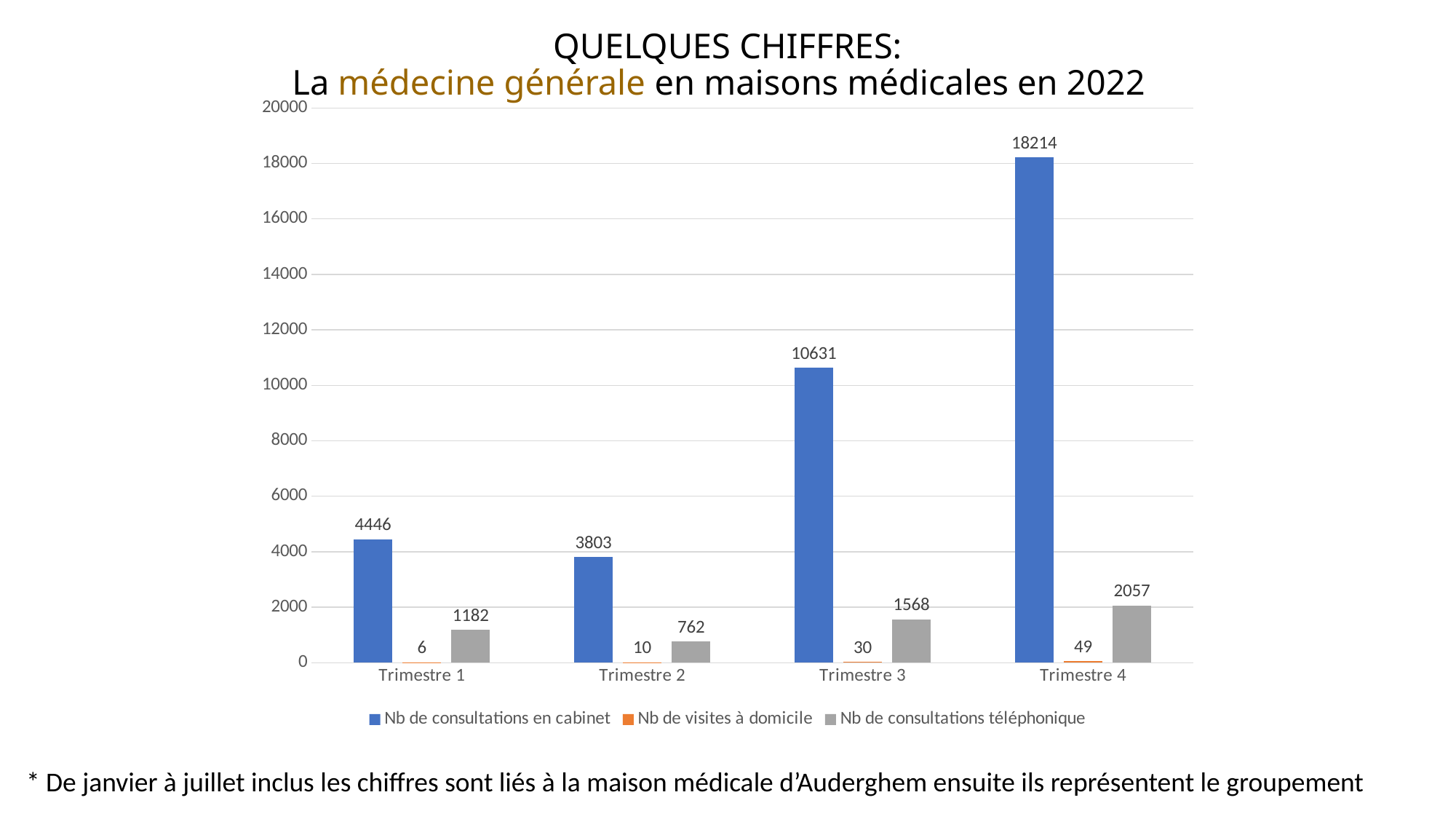
Is the value for 'Nb de consultations en cabinet' in Trimestre 3 greater or less than 10000? greater What kind of chart is shown on the slide? Bar chart What is the value of 'Nb de consultations en cabinet' for Trimestre 4? 18214 What is the value of 'Nb de consultations téléphonique' for Trimestre 1? 1182 Which trimestre has the lowest value for 'Nb de consultations téléphonique'? Trimestre 2 What is the value of 'Nb de visites à domicile' for Trimestre 3? 30 How many series does the legend list? 3 What is the difference between 'Nb de consultations en cabinet' in Trimestre 4 and Trimestre 3? 7583 Which trimestre has the highest value for 'Nb de consultations en cabinet'? Trimestre 4 Which colour represents 'Nb de visites à domicile' in the legend? Orange Which is larger: 'Nb de consultations en cabinet' in Trimestre 1 or in Trimestre 2? Trimestre 1 How many trimestres (categories) are shown on the x axis? 4